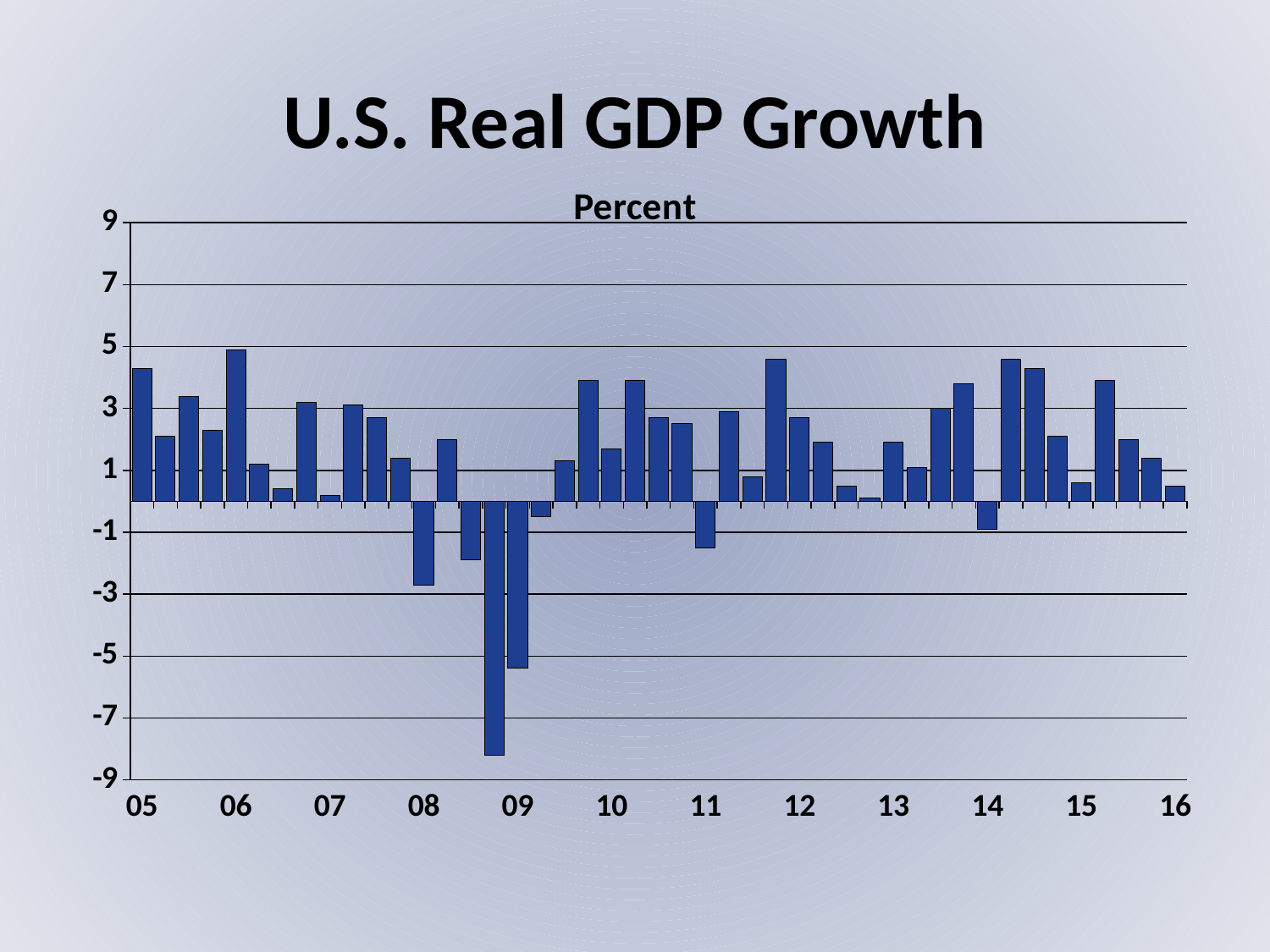
What unit label is shown above the y axis? Percent What is the title of the chart? U.S. Real GDP Growth What kind of chart is shown on the slide? bar chart Is the value of the bar at the 09 label greater or less than -3? less Is the value of the bar at the 06 label greater or less than 3? greater Is the value of the bar at the 08 label greater or less than -1? less Which is larger, the bar at the 06 label or the bar at the 08 label? 06 Between the 08 label and the 09 label, do the bar values rise or fall? fall How many year labels are shown along the x axis? 12